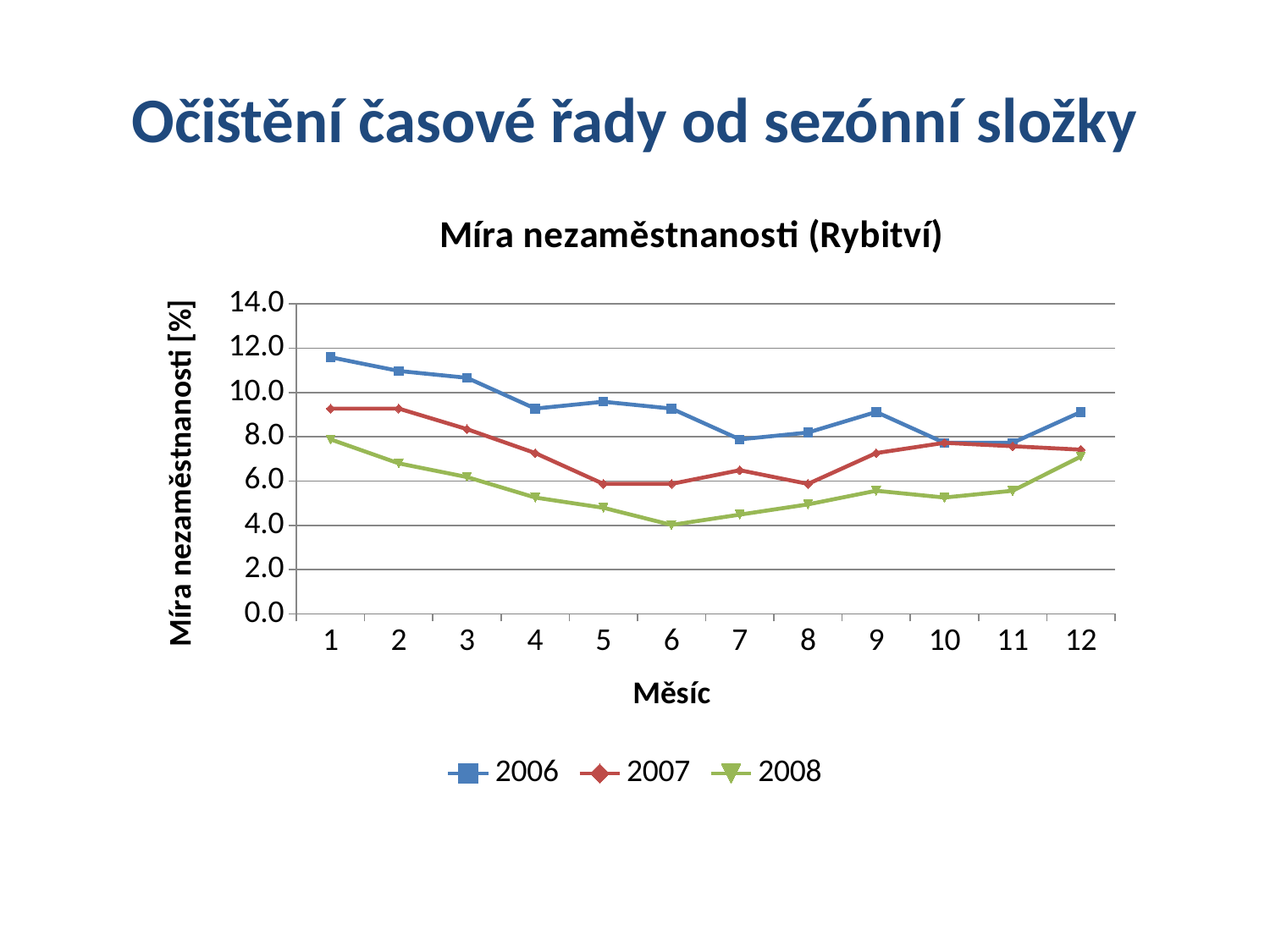
In which month does the 2008 series reach its lowest value? 6 What is the title of the chart? Míra nezaměstnanosti (Rybitví) Does the 2006 series rise or fall from month 1 to month 4? fall Is the value for 2008 in month 6 greater or less than 6.0? less What is the label of the y axis? Míra nezaměstnanosti [%] How many months are plotted along the x axis? 12 Which series has the larger value in month 1, 2006 or 2008? 2006 How many series does the legend list? 3 In which month does the 2006 series reach its highest value? 1 What kind of chart is shown on the slide? line chart Is the value for 2006 in month 1 greater or less than 10.0? greater Is the value for 2007 in month 5 greater or less than 8.0? less